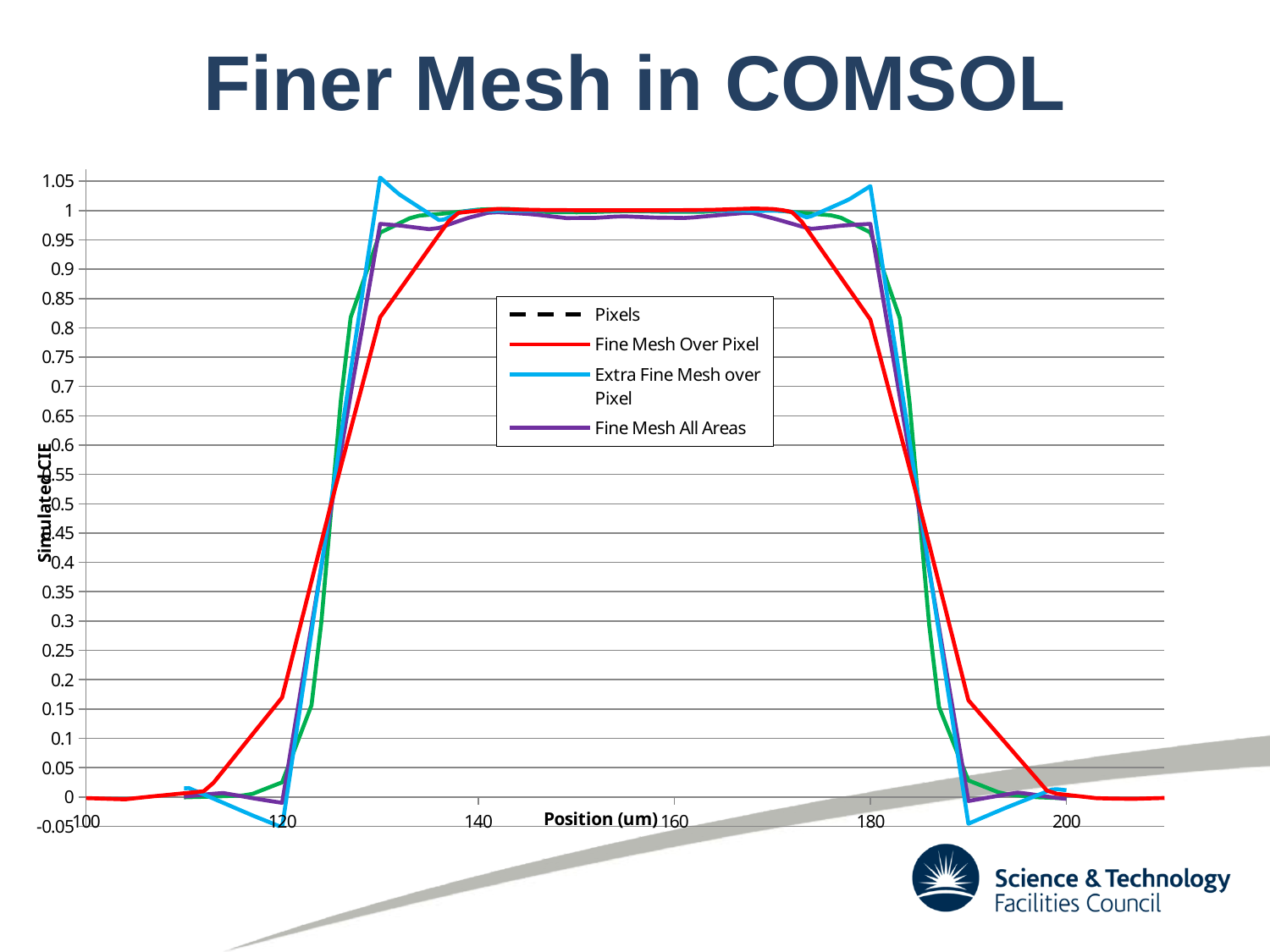
How many series does the chart legend list? 4 Is the value of Fine Mesh Over Pixel at position 190 greater or less than 0.2? less Is the value of Fine Mesh Over Pixel at position 160 greater or less than 0.9? greater Is the value of Fine Mesh All Areas at position 160 greater or less than 0.9? greater What kind of chart is shown on the slide? line chart What is the label of the y axis? Simulated CIE Does the Fine Mesh Over Pixel series rise or fall between positions 120 and 140? rise What is the label of the x axis? Position (um) Does the Fine Mesh Over Pixel series rise or fall between positions 180 and 200? fall